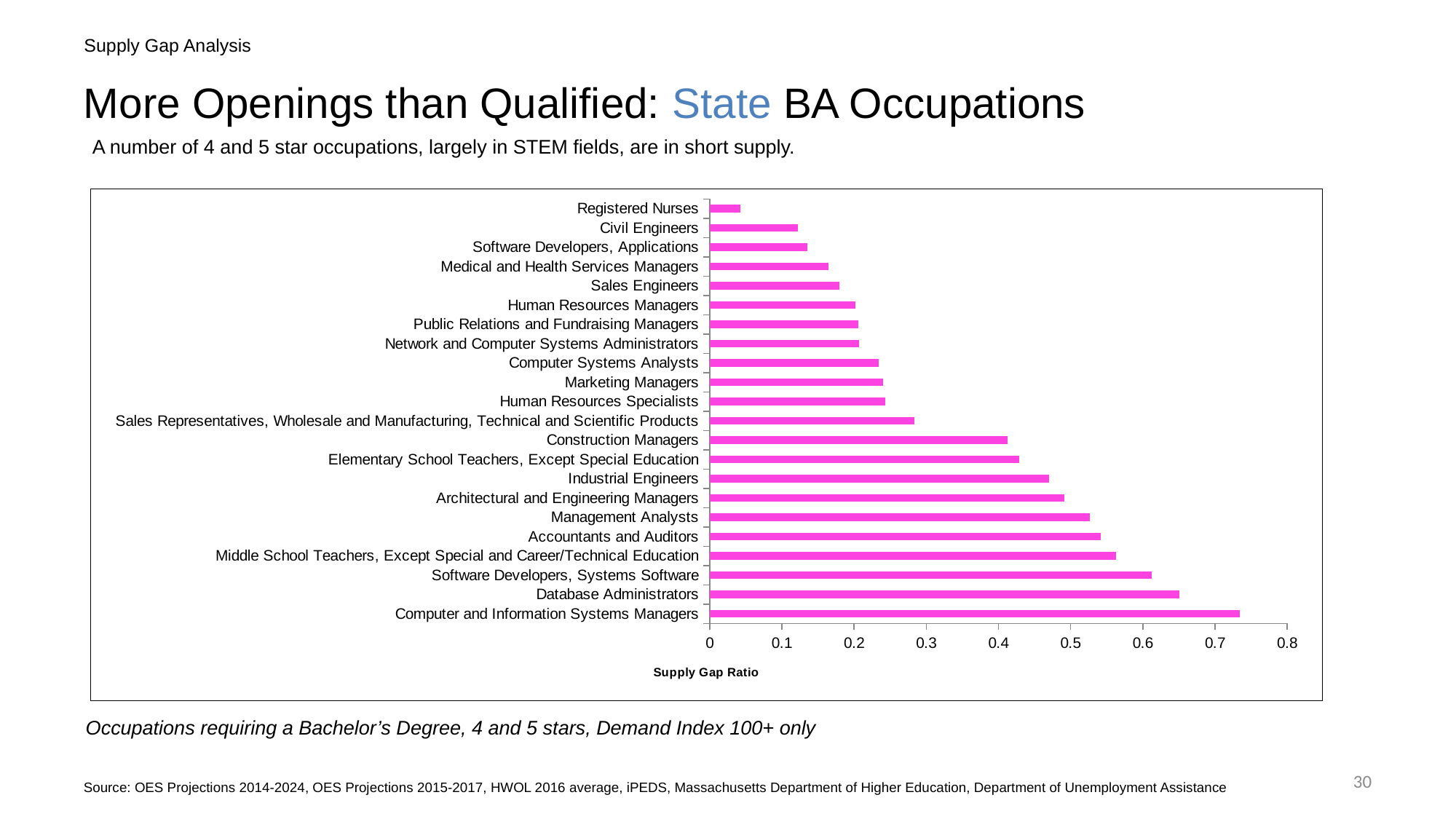
What kind of chart is shown on the slide? Bar chart Which has a larger supply gap ratio, Software Developers, Systems Software or Software Developers, Applications? Software Developers, Systems Software Is the supply gap ratio for Registered Nurses greater or less than 0.1? less Which occupation has the lowest supply gap ratio? Registered Nurses How many occupations are plotted in the chart? 22 Is the supply gap ratio for Construction Managers greater or less than 0.5? less Is the supply gap ratio for Industrial Engineers greater or less than 0.4? greater What is the title of the horizontal axis of the chart? Supply Gap Ratio Which occupation has the highest supply gap ratio? Computer and Information Systems Managers Which has a larger supply gap ratio, Civil Engineers or Management Analysts? Management Analysts